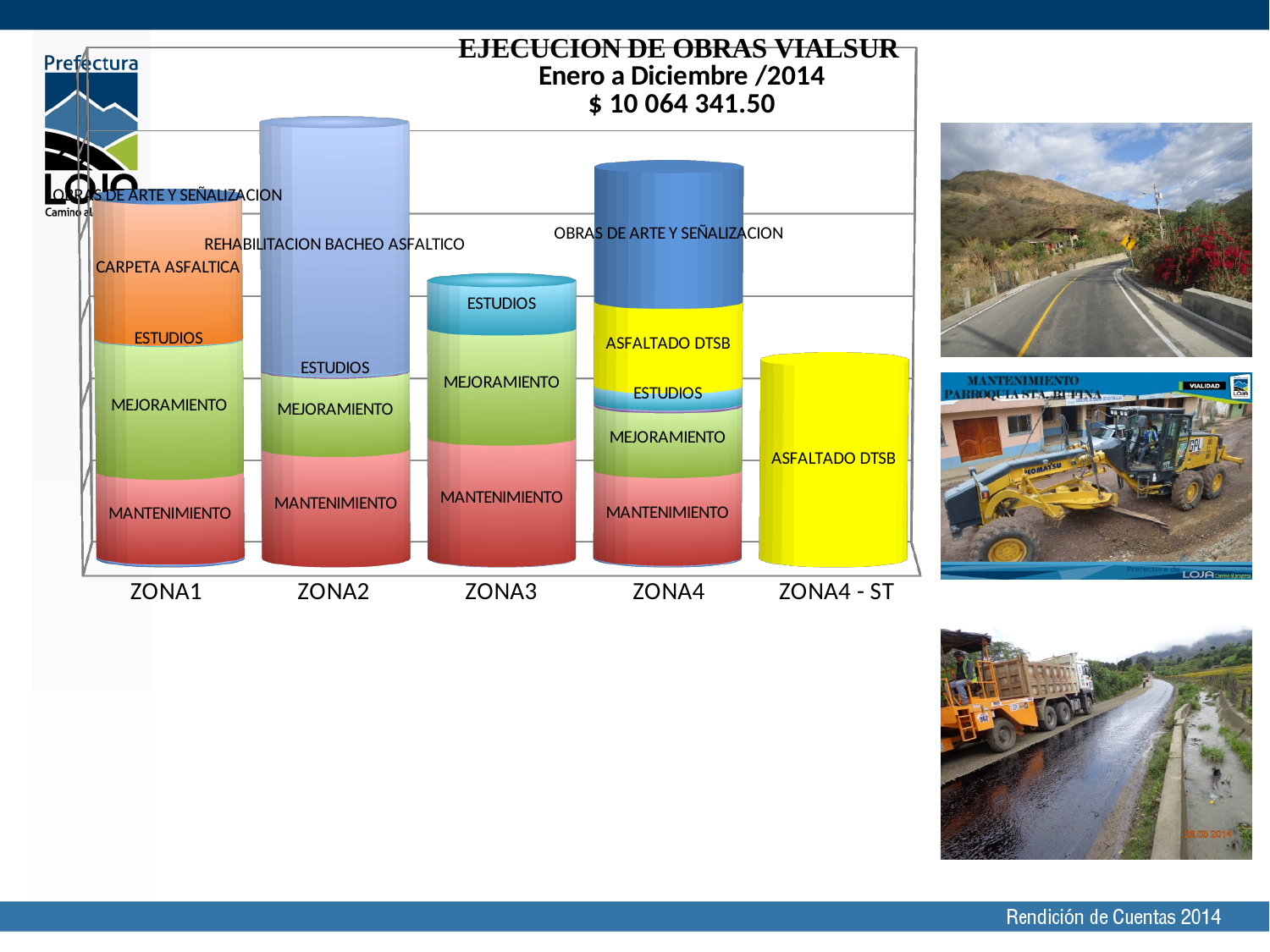
What period does the chart title say the data covers? Enero a Diciembre /2014 Which zone has the tallest stacked bar in the chart? ZONA2 What is the only segment in the ZONA4 - ST bar? ASFALTADO DTSB What total amount is shown in the chart title? $ 10 064 341.50 Which segment appears only in the ZONA2 bar? REHABILITACION BACHEO ASFALTICO Which zone has the shortest stacked bar in the chart? ZONA4 - ST Which stacked bar is taller, ZONA2 or ZONA4? ZONA2 What kind of chart is shown on the slide? Stacked bar chart How many zones (categories) are shown along the x axis of the chart? 5 Which stacked bar is taller, ZONA1 or ZONA3? ZONA1